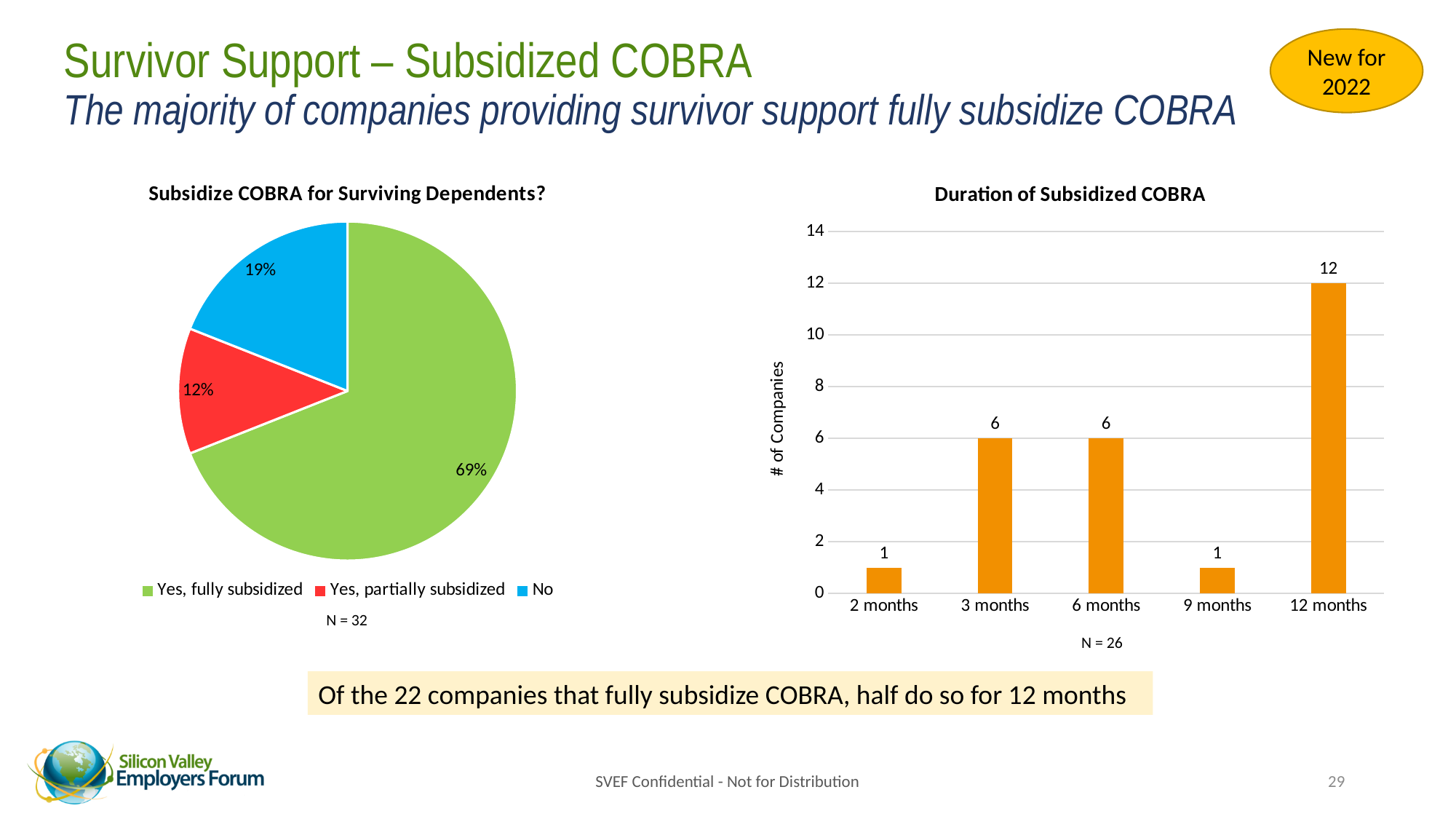
In the 'Duration of Subsidized COBRA' chart, which duration has the fewest companies? 2 months and 9 months (1 each) In the 'Subsidize COBRA for Surviving Dependents?' chart, what share of companies answered 'Yes, fully subsidized'? 69% In the 'Subsidize COBRA for Surviving Dependents?' chart, which response has the smallest slice? Yes, partially subsidized In the 'Subsidize COBRA for Surviving Dependents?' chart, what share of companies answered 'No'? 19% In the 'Duration of Subsidized COBRA' chart, how many companies subsidize COBRA for 12 months? 12 In the 'Duration of Subsidized COBRA' chart, how many companies subsidize COBRA for 3 months? 6 What kind of chart is 'Subsidize COBRA for Surviving Dependents?'? Pie chart In the 'Duration of Subsidized COBRA' chart, how many duration categories are shown on the x axis? 5 How many categories does the legend of the 'Subsidize COBRA for Surviving Dependents?' chart list? 3 What kind of chart is 'Duration of Subsidized COBRA'? Bar chart In the 'Duration of Subsidized COBRA' chart, what is the difference between the number of companies at 12 months and at 6 months? 6 In the 'Subsidize COBRA for Surviving Dependents?' chart, what share of companies answered 'Yes, partially subsidized'? 12%